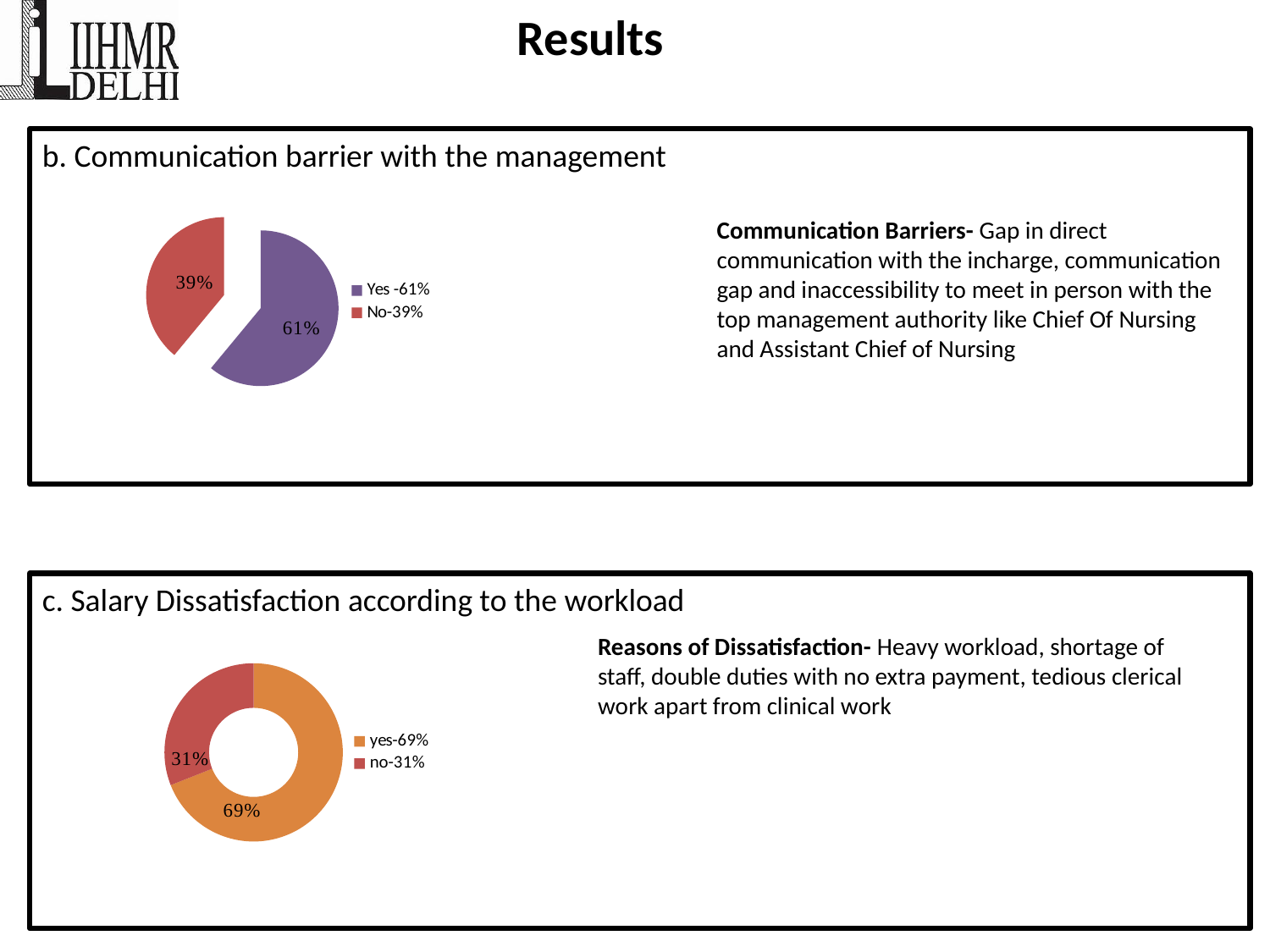
In the 'Communication barrier with the management' chart, what percentage is shown for No? 39% In the 'Salary Dissatisfaction according to the workload' chart, what is the difference in percentage points between yes and no? 38 In the 'Communication barrier with the management' chart, what is the difference in percentage points between Yes and No? 22 What kind of chart is used in the 'Communication barrier with the management' section? Pie chart In the 'Salary Dissatisfaction according to the workload' chart, what colour is the yes segment? Orange In the 'Salary Dissatisfaction according to the workload' chart, which category has the smaller share? no In the 'Salary Dissatisfaction according to the workload' chart, what percentage is shown for yes? 69% What kind of chart is used in the 'Salary Dissatisfaction according to the workload' section? Doughnut chart In the 'Salary Dissatisfaction according to the workload' chart, what percentage is shown for no? 31% In the 'Communication barrier with the management' chart, what percentage is shown for Yes? 61% In the 'Communication barrier with the management' chart, which category has the larger share? Yes How many entries does the legend list in the 'Communication barrier with the management' chart? 2